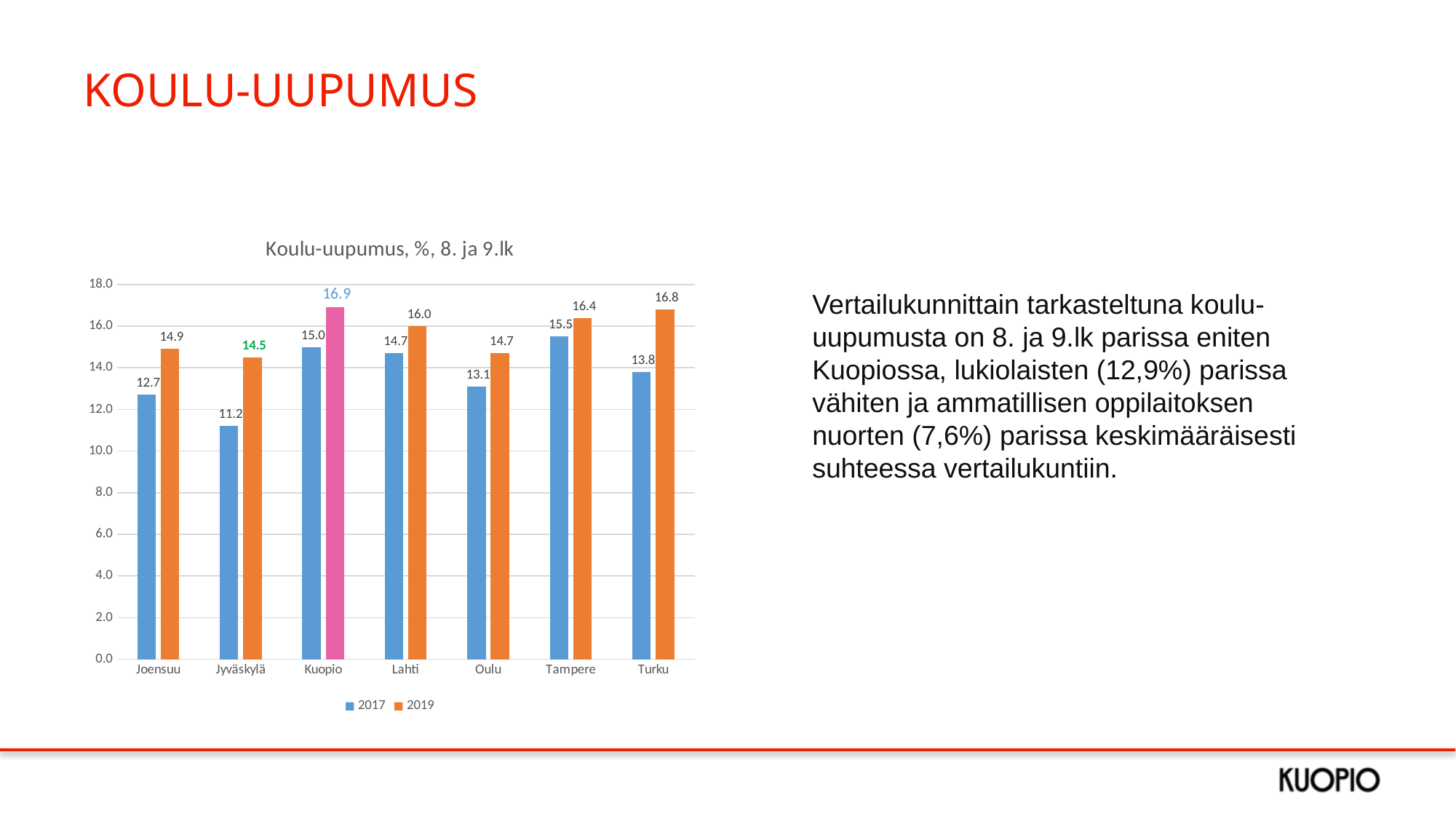
What kind of chart is shown? Bar chart What is the difference between the 2019 and 2017 values for Kuopio? 1.9 What is the 2019 value for Turku? 16.8 How many cities are shown on the x axis? 7 Which city has the highest 2019 value? Kuopio Which is larger, the 2019 value for Lahti or the 2019 value for Oulu? Lahti What is the 2017 value for Tampere? 15.5 Which city has the lowest 2017 value? Jyväskylä How many series does the legend list? 2 What is the 2019 value for Kuopio? 16.9 What is the 2017 value for Jyväskylä? 11.2 Which city has the highest 2017 value? Tampere